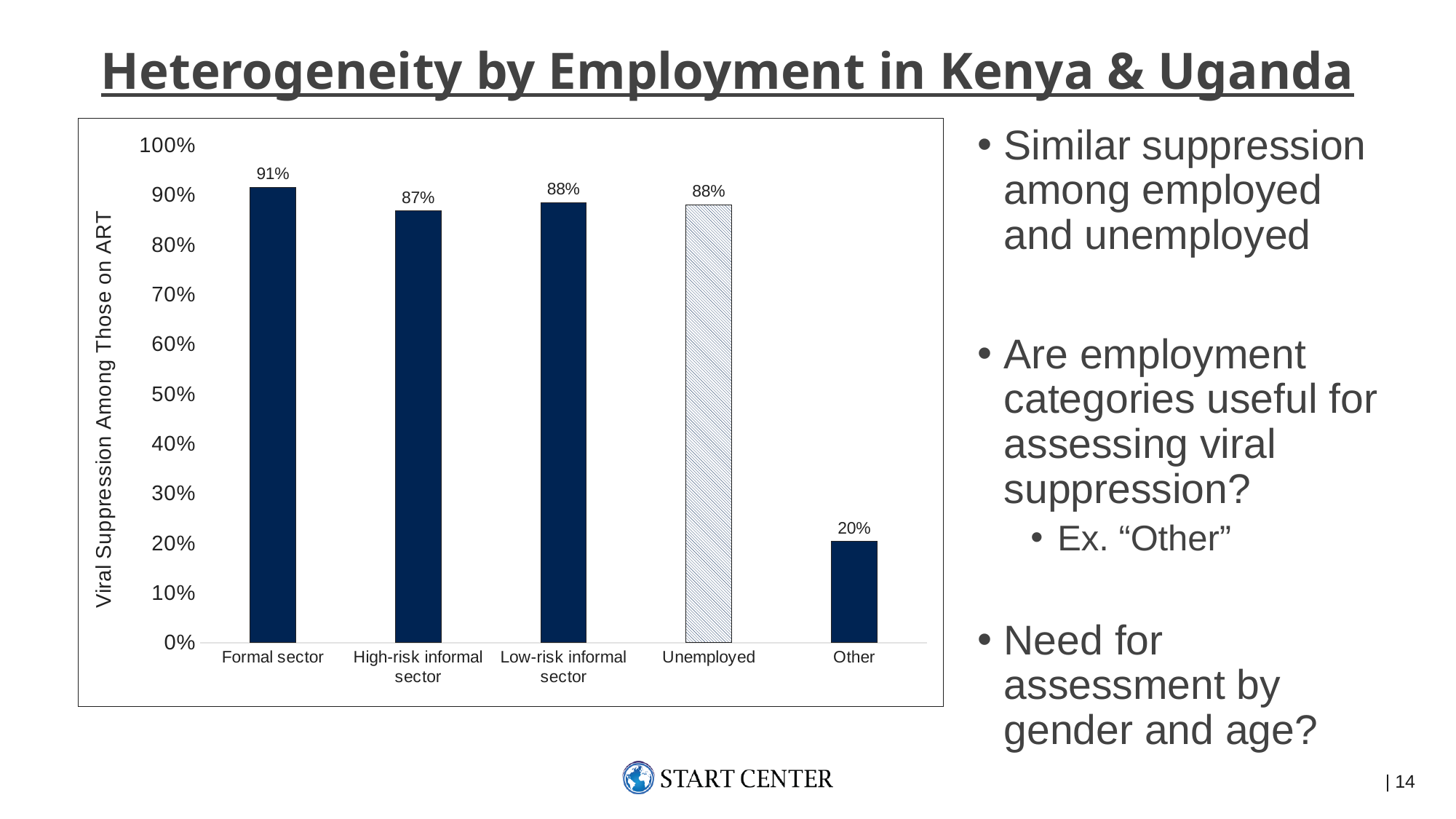
Which category has the lowest viral suppression? Other Is the value for Other greater or less than 30%? less What is the viral suppression value for Unemployed? 88% What is the viral suppression value for the High-risk informal sector? 87% Which is larger, the value for Formal sector or High-risk informal sector? Formal sector What is the viral suppression value for Other? 20% What is the label of the vertical axis? Viral Suppression Among Those on ART What is the difference between the Formal sector and Other values? 71% What kind of chart is shown on the slide? bar chart Which category has the highest viral suppression? Formal sector How many employment categories are shown in the chart? 5 What is the viral suppression value for the Formal sector? 91%